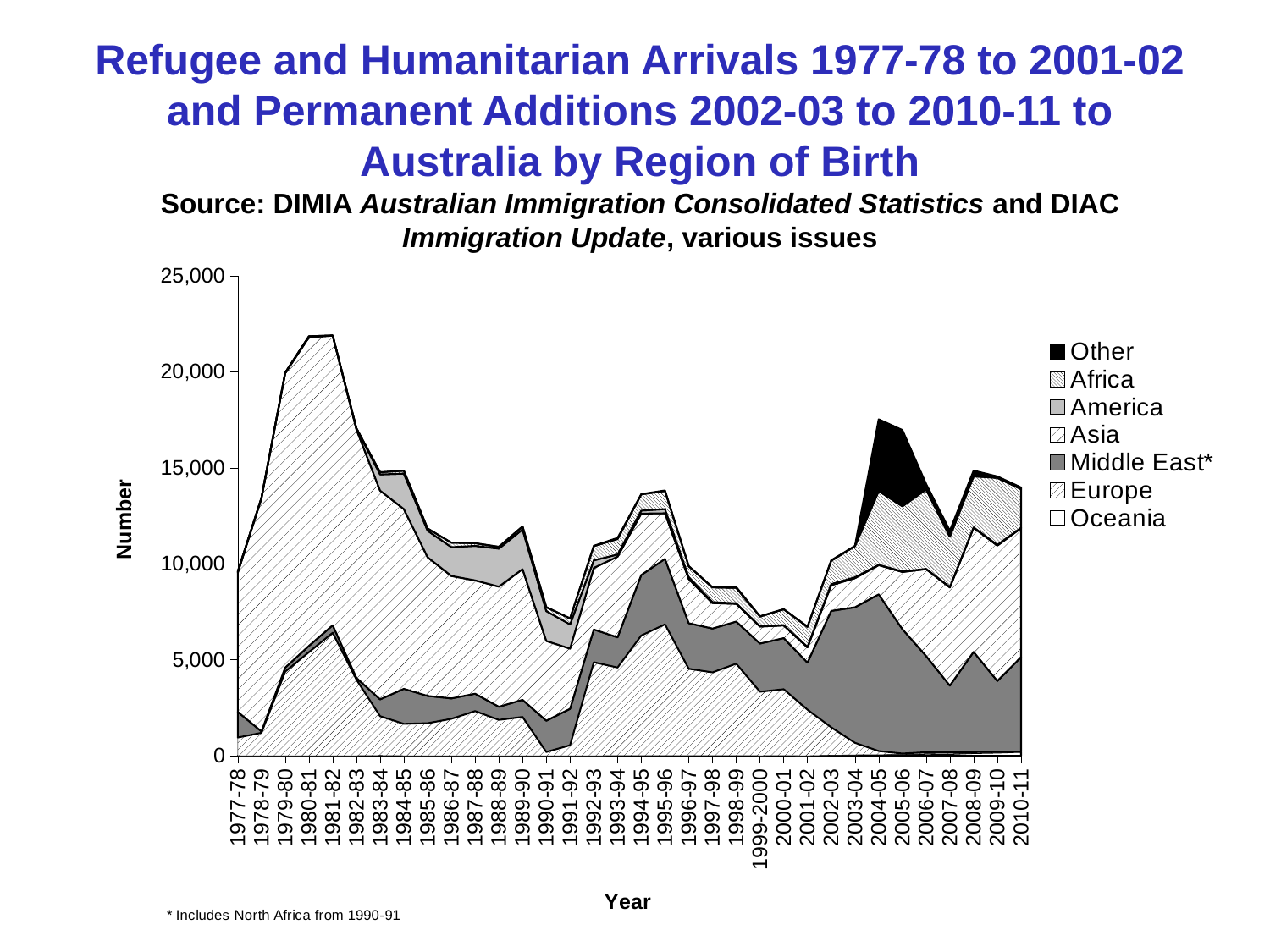
How many years are shown along the x axis? 34 Is the total number of arrivals in 1990-91 greater or less than 10,000? less Which legend entry is marked with an asterisk? Middle East* Is the total number of arrivals in 1991-92 greater or less than 10,000? less Does the total number of arrivals rise or fall from 1977-78 to 1981-82? rise In which year is the total number of arrivals highest? 1981-82 What is the label on the vertical axis? Number Which is larger, the total number of arrivals in 1981-82 or in 2004-05? 1981-82 Is the total number of arrivals in 2004-05 greater or less than 15,000? greater How many series does the legend list? 7 What kind of chart is shown on the slide? Stacked area chart